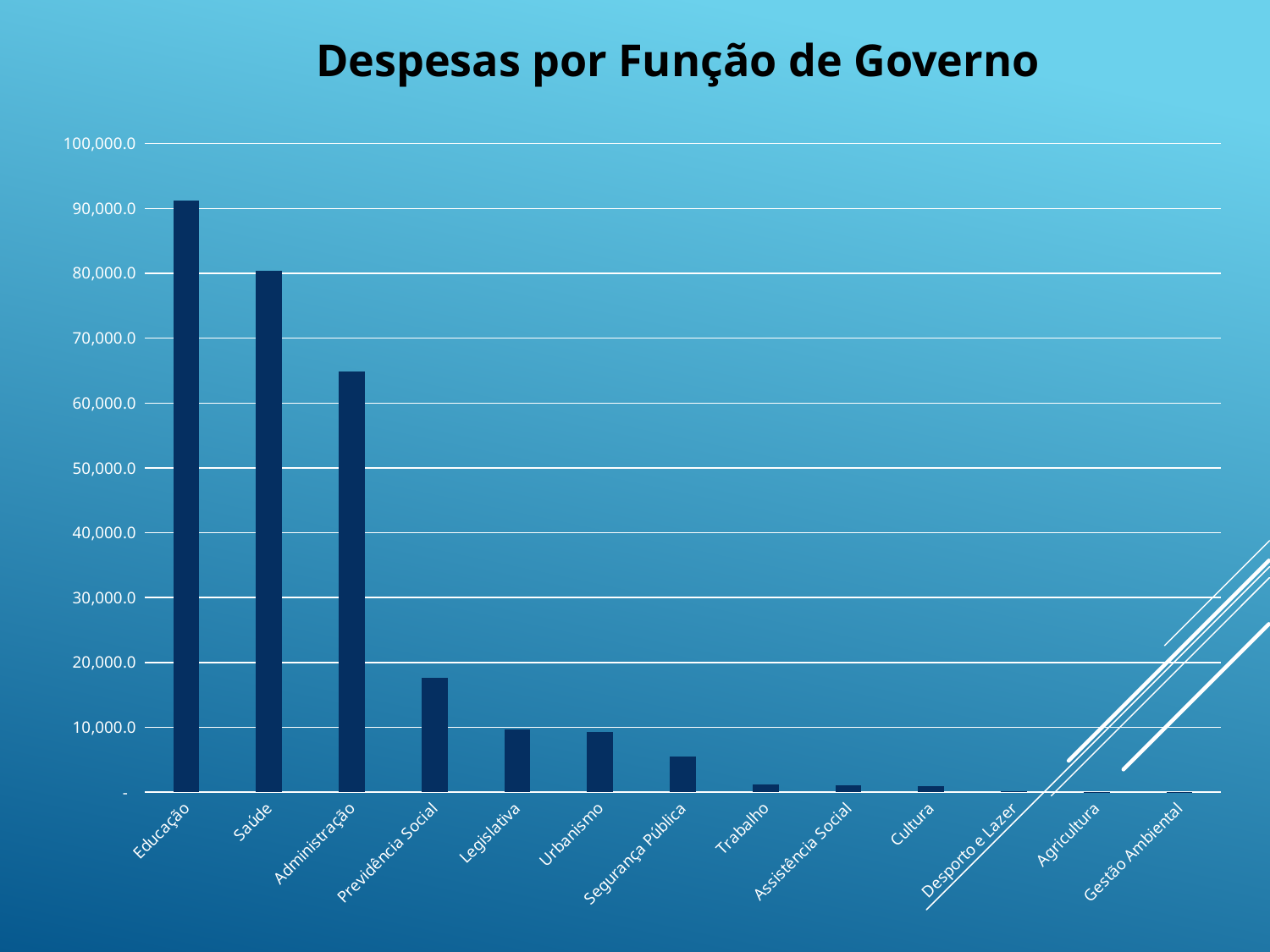
What is the title of the chart? Despesas por Função de Governo Is the value for Segurança Pública greater or less than 10,000.0? less Is the value for Previdência Social greater or less than 20,000.0? less Is the value for Educação greater or less than 80,000.0? greater How many categories are shown on the x axis of the chart? 13 Which category has the highest value in the chart? Educação Do the values rise or fall moving from left to right along the x axis? fall What type of chart is shown on the slide? Bar chart Which has a larger value, Previdência Social or Legislativa? Previdência Social Which has a larger value, Educação or Saúde? Educação